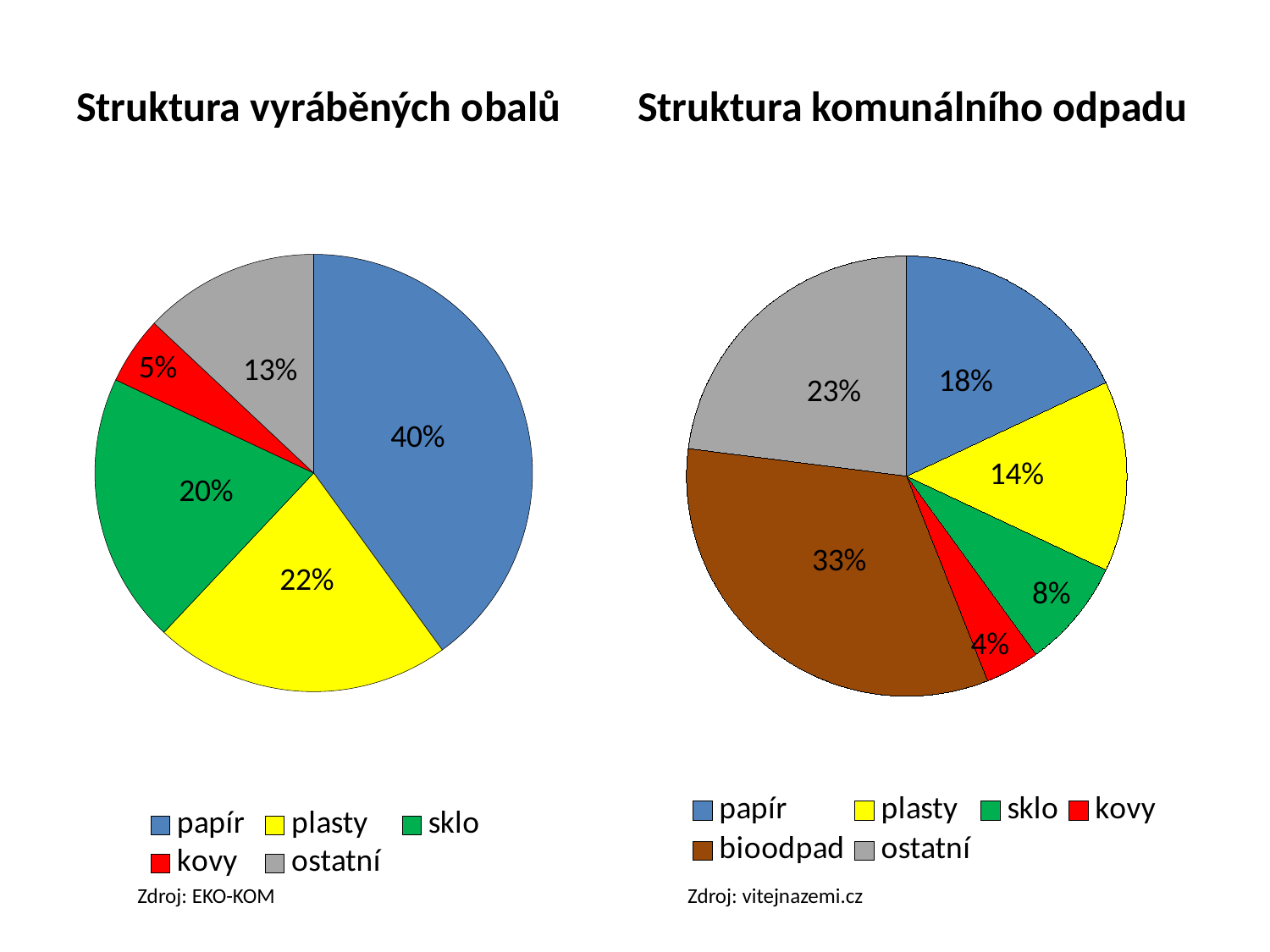
In the 'Struktura vyráběných obalů' chart, what is the difference between the shares of plasty and sklo? 2% In the 'Struktura komunálního odpadu' chart, what share does ostatní have? 23% In the 'Struktura vyráběných obalů' chart, which category has the largest share? papír In the 'Struktura komunálního odpadu' chart, what share does bioodpad have? 33% How many entries does the legend of the 'Struktura vyráběných obalů' chart list? 5 In the 'Struktura vyráběných obalů' chart, what colour is the kovy slice? red In the 'Struktura komunálního odpadu' chart, which category has the smallest share? kovy In the 'Struktura vyráběných obalů' chart, what share does papír have? 40% How many slices does the 'Struktura komunálního odpadu' chart have? 6 Which category appears in the legend of the 'Struktura komunálního odpadu' chart but not in the legend of the 'Struktura vyráběných obalů' chart? bioodpad What kind of chart is 'Struktura vyráběných obalů'? pie chart In the 'Struktura komunálního odpadu' chart, which is larger, the share of papír or the share of plasty? papír